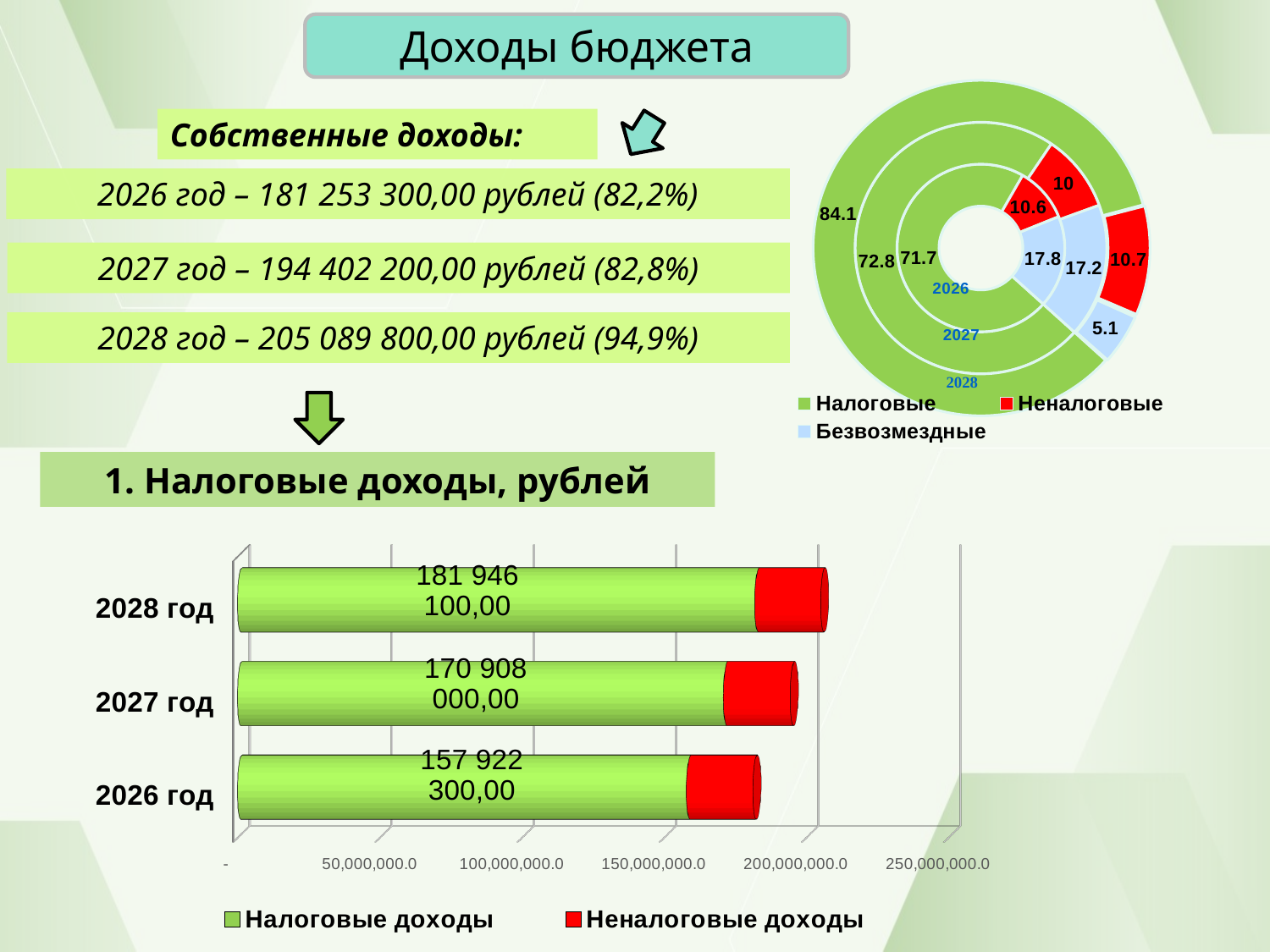
In the chart "1. Налоговые доходы, рублей", which year has the highest Налоговые доходы? 2028 год In the doughnut chart at the top right, which is larger: Безвозмездные for 2026 or Безвозмездные for 2028? 2026 In the chart "1. Налоговые доходы, рублей", how many series does the legend list? 2 In the doughnut chart at the top right, how many series does the legend list? 3 In the chart "1. Налоговые доходы, рублей", what is the value of Налоговые доходы for 2028 год? 181 946 100,00 What kind of chart is the chart titled "1. Налоговые доходы, рублей"? bar chart In the doughnut chart at the top right, what is the value of Безвозмездные for 2026? 17.8 In the doughnut chart at the top right, what is the value of Налоговые for 2028? 84.1 In the chart "1. Налоговые доходы, рублей", how many years are shown? 3 In the chart "1. Налоговые доходы, рублей", do the Налоговые доходы values rise or fall from 2026 год to 2028 год? rise In the chart "1. Налоговые доходы, рублей", what is the difference between Налоговые доходы for 2028 год and 2026 год? 24 023 800,00 In the chart "1. Налоговые доходы, рублей", what is the value of Налоговые доходы for 2026 год? 157 922 300,00